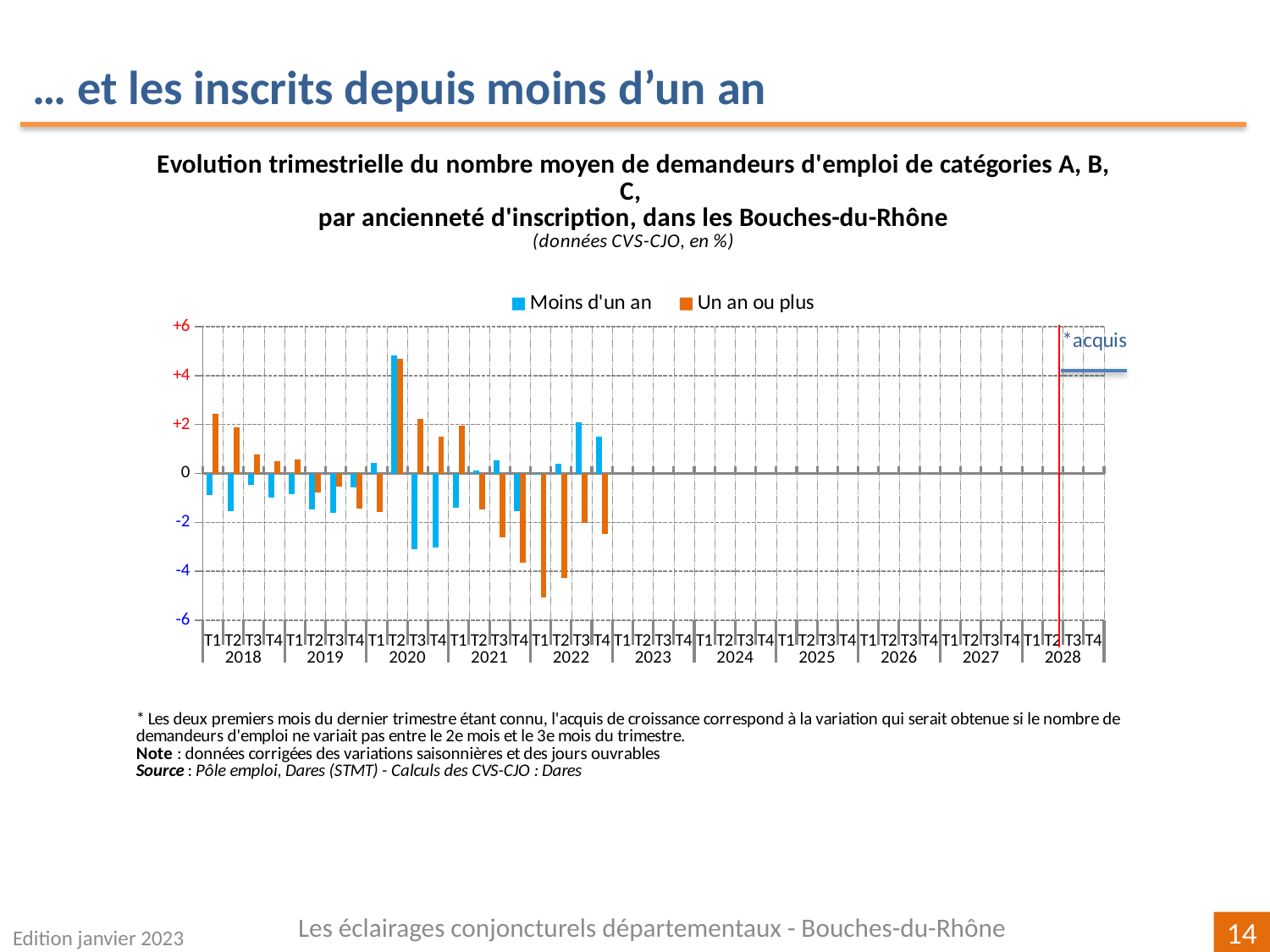
What are the two series named in the legend? Moins d'un an; Un an ou plus Is the 'Un an ou plus' value for T4 2021 greater or less than -2? less What kind of chart is shown on the slide? bar chart How many years are labelled along the x axis? 11 Is the 'Moins d'un an' value for T2 2020 greater or less than +4? greater How many series does the legend list? 2 What label appears next to the red vertical line at the right of the chart? *acquis In which quarter is the 'Moins d'un an' value highest? T2 2020 Is the 'Moins d'un an' value for T3 2020 greater or less than -2? less In which quarter is the 'Un an ou plus' value lowest? T1 2022 Which is larger, the 'Moins d'un an' value for T3 2020 or for T3 2022? T3 2022